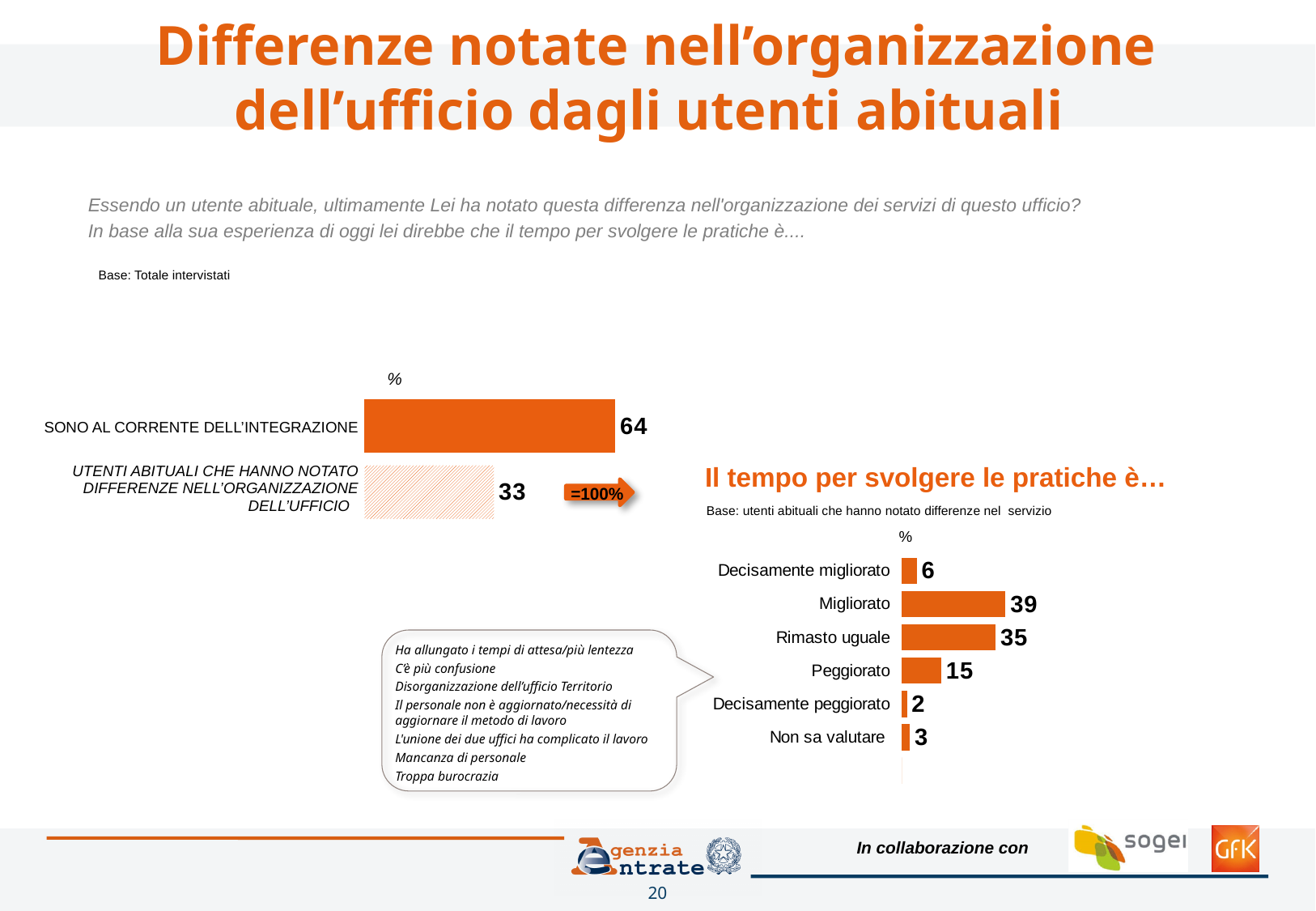
How many categories are shown in the chart titled 'Il tempo per svolgere le pratiche è…'? 6 In the chart titled 'Il tempo per svolgere le pratiche è…', which category has the highest value? Migliorato What is the base stated under the title of the chart 'Il tempo per svolgere le pratiche è…'? Utenti abituali che hanno notato differenze nel servizio In the chart titled 'Il tempo per svolgere le pratiche è…', what is the difference between Migliorato and Rimasto uguale? 4 In the left chart, what is the difference between the value for SONO AL CORRENTE DELL'INTEGRAZIONE and the value for UTENTI ABITUALI CHE HANNO NOTATO DIFFERENZE NELL'ORGANIZZAZIONE DELL'UFFICIO? 31 In the chart titled 'Il tempo per svolgere le pratiche è…', which is larger: Decisamente migliorato or Non sa valutare? Decisamente migliorato What kind of chart is the chart titled 'Il tempo per svolgere le pratiche è…'? Bar chart In the left chart, what is the value for UTENTI ABITUALI CHE HANNO NOTATO DIFFERENZE NELL'ORGANIZZAZIONE DELL'UFFICIO? 33 In the left chart, what is the value for SONO AL CORRENTE DELL'INTEGRAZIONE? 64 In the chart titled 'Il tempo per svolgere le pratiche è…', what is the value for Peggiorato? 15 In the chart titled 'Il tempo per svolgere le pratiche è…', which category has the lowest value? Decisamente peggiorato In the chart titled 'Il tempo per svolgere le pratiche è…', what is the value for Migliorato? 39